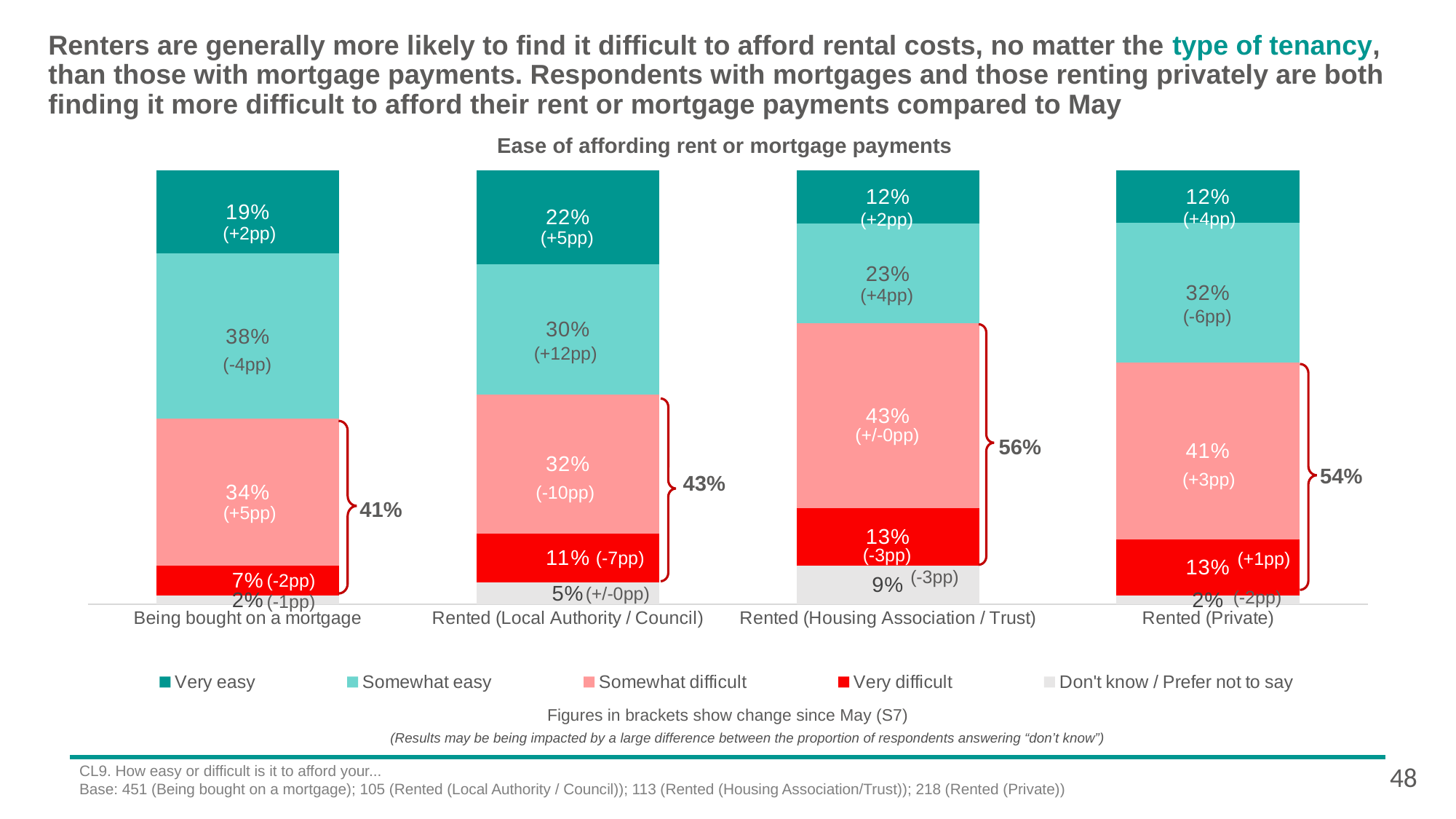
How many series does the legend list? 5 What is the 'Somewhat difficult' value for 'Rented (Housing Association / Trust)'? 43% What is the difference between the 'Somewhat difficult' values for 'Rented (Housing Association / Trust)' and 'Being bought on a mortgage'? 9 percentage points Which category has the highest 'Somewhat easy' value? Being bought on a mortgage What is the 'Don't know / Prefer not to say' value for 'Rented (Private)'? 2% What type of chart is shown on the slide? Stacked bar chart Which category has the lowest 'Very difficult' value? Being bought on a mortgage What is the 'Very difficult' value for 'Rented (Local Authority / Council)'? 11% What is the combined 'Somewhat difficult' and 'Very difficult' share shown by the bracket for 'Rented (Housing Association / Trust)'? 56% How many tenancy categories are shown on the x axis? 4 What percentage of respondents in the 'Being bought on a mortgage' category said it was 'Very easy' to afford their payments? 19% Which is larger: the 'Very easy' value for 'Rented (Local Authority / Council)' or for 'Rented (Private)'? Rented (Local Authority / Council)